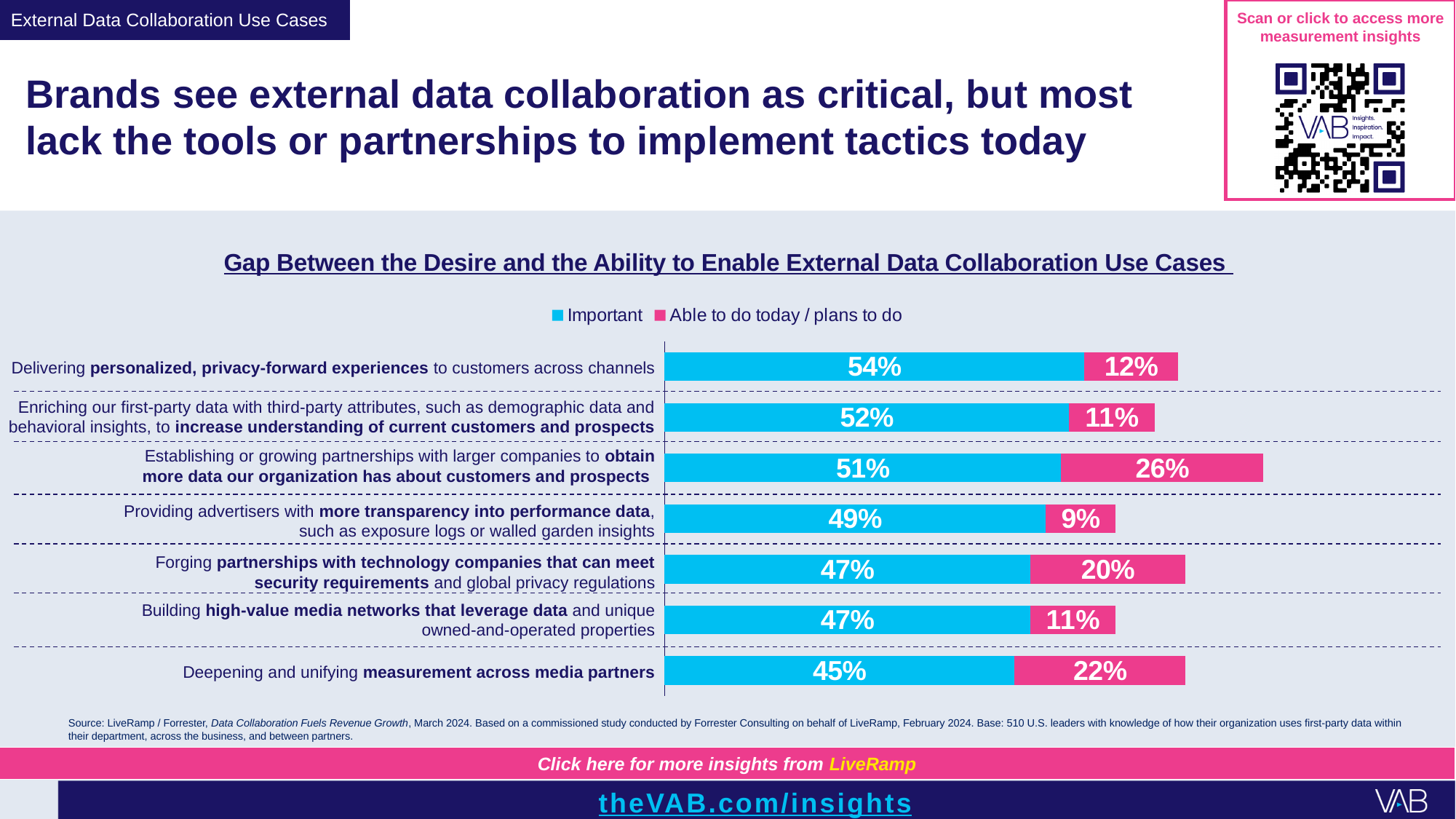
How many use cases (categories) are plotted in the chart? 7 What is the 'Important' value for 'Delivering personalized, privacy-forward experiences to customers across channels'? 54% Which use case has the lowest 'Able to do today / plans to do' value? Providing advertisers with more transparency into performance data What is the 'Able to do today / plans to do' value for 'Providing advertisers with more transparency into performance data'? 9% What is the combined total of the two segments for 'Enriching our first-party data with third-party attributes'? 63% What is the 'Able to do today / plans to do' value for 'Establishing or growing partnerships with larger companies to obtain more data our organization has about customers and prospects'? 26% How many series does the legend list? 2 Which is larger: the 'Able to do today / plans to do' value for 'Forging partnerships with technology companies that can meet security requirements' or for 'Building high-value media networks that leverage data'? Forging partnerships with technology companies that can meet security requirements What colour represents the 'Important' series in the chart? Blue Which use case has the highest 'Important' value? Delivering personalized, privacy-forward experiences to customers across channels What kind of chart is shown on the slide? Stacked bar chart What is the difference between the 'Important' and 'Able to do today / plans to do' values for 'Deepening and unifying measurement across media partners'? 23%